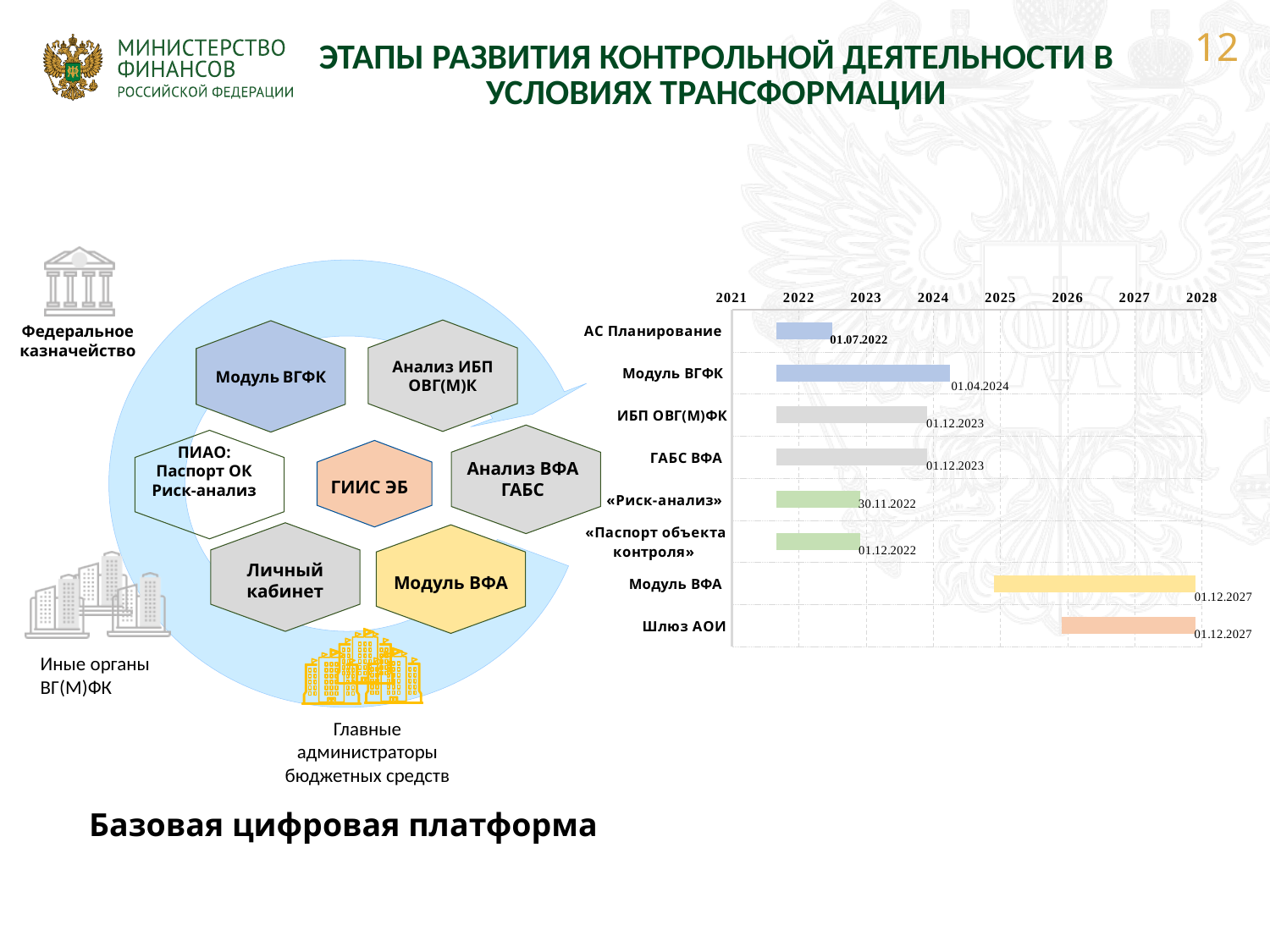
What end date is labelled on the bar for ИБП ОВГ(М)ФК? 01.12.2023 Which item in the timeline chart has the earliest labelled end date? АС Планирование Does the bar for Модуль ВФА end before or after the 2027 tick on the axis? After What is the first year and the last year shown on the chart's horizontal axis? 2021 and 2028 What end date is labelled on the bar for Шлюз АОИ? 01.12.2027 Which ends later, Модуль ВГФК or ГАБС ВФА? Модуль ВГФК What kind of chart is used to show the development stages on the right of the slide? Bar chart What end date is labelled on the bar for АС Планирование? 01.07.2022 What end date is labelled on the bar for «Паспорт объекта контроля»? 01.12.2022 What end date is labelled on the bar for «Риск-анализ»? 30.11.2022 What end date is labelled on the bar for Модуль ВГФК? 01.04.2024 How many items (rows) are shown in the timeline chart? 8